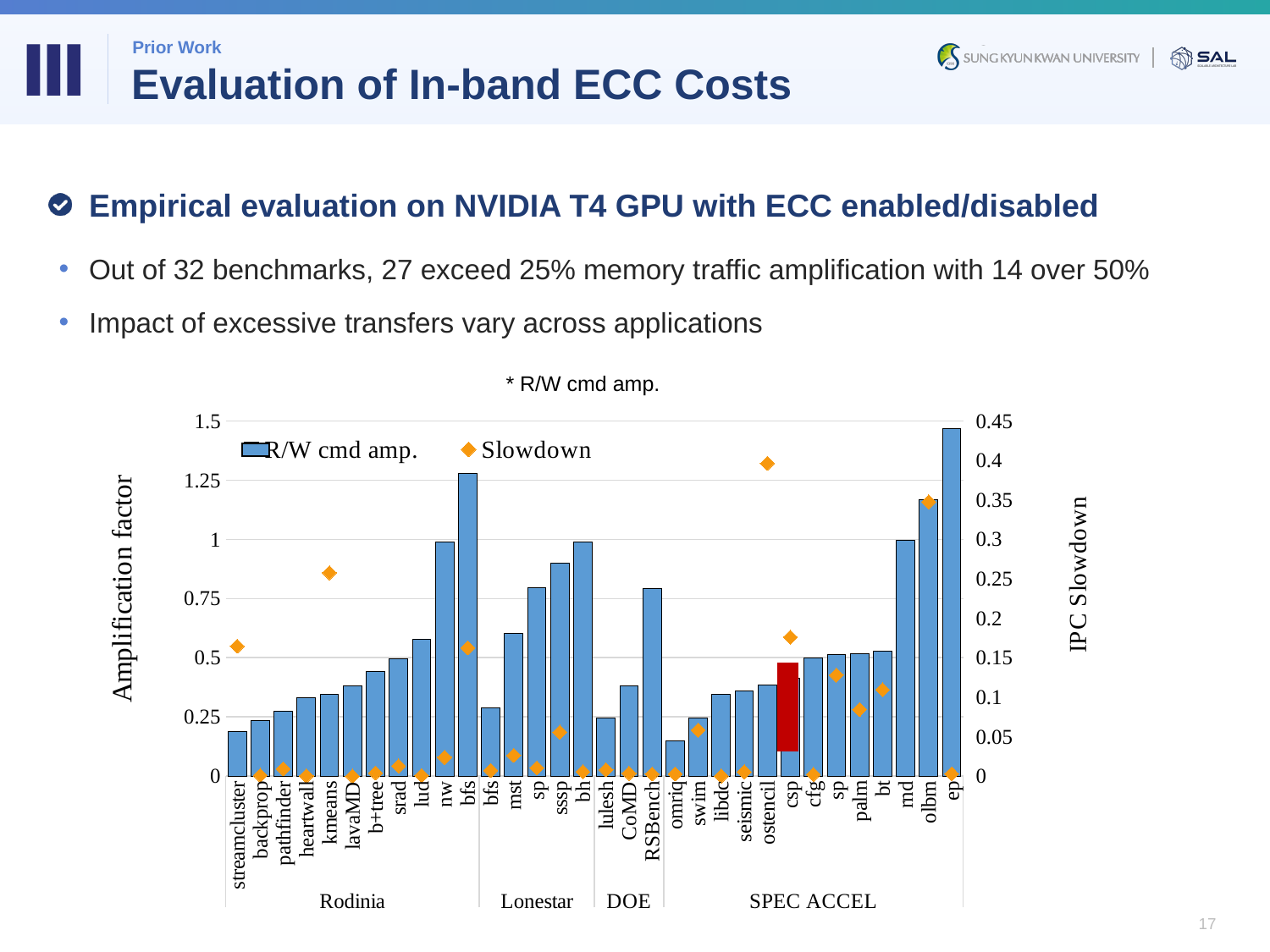
Which has the larger R/W cmd amp. bar, sssp or mst? sssp Which benchmark has the highest Slowdown marker? ostencil How many benchmark suite groups are labelled along the x axis? 4 Is the Slowdown value for kmeans greater or less than 0.2? greater Which benchmark's bar is highlighted in red? csp Which benchmark has the lowest R/W cmd amp. bar? omriq What kind of chart is shown on the slide? combination chart with bars and diamond markers Is the R/W cmd amp. value for omriq greater or less than 0.25? less How many series does the chart legend list? 2 Is the R/W cmd amp. value for bfs in the Rodinia group greater or less than 1? greater Which benchmark has the highest R/W cmd amp. bar? ep